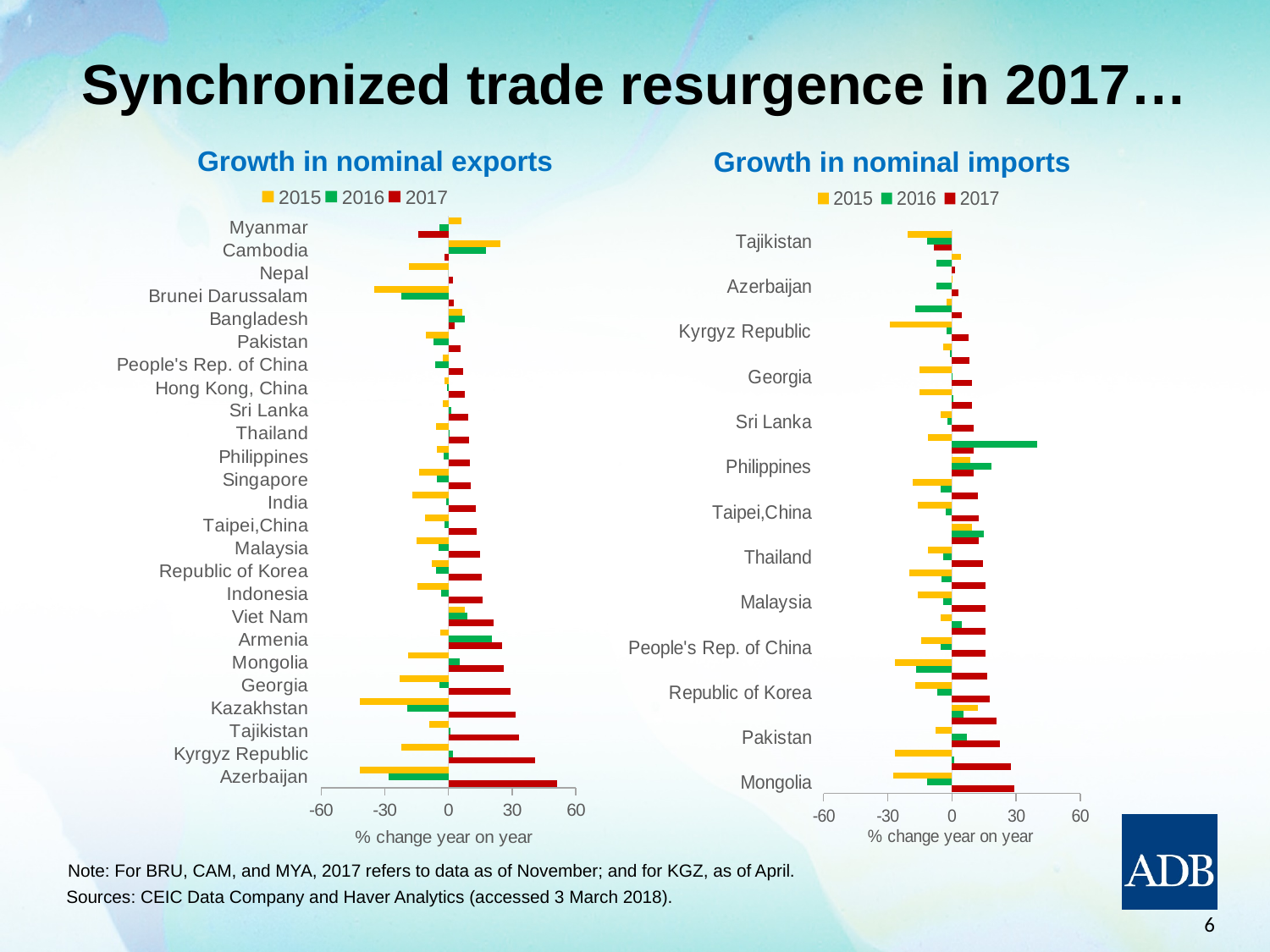
In the 'Growth in nominal exports' chart, how many economies are listed on the vertical axis? 25 In the 'Growth in nominal exports' chart, is the 2015 value for Kazakhstan greater or less than -30? less In the 'Growth in nominal imports' chart, is the 2017 value for Pakistan greater or less than 0? greater What kind of chart is the 'Growth in nominal exports' chart? Bar chart How many series does the legend of the 'Growth in nominal imports' chart list? 3 In the 'Growth in nominal exports' chart, is the 2017 value for Azerbaijan greater or less than 30? greater What is the x-axis label on the 'Growth in nominal imports' chart? % change year on year In the 'Growth in nominal exports' chart, which economy has the highest 2017 value? Azerbaijan Which colour represents 2017 in the legend of the 'Growth in nominal exports' chart? Red In the 'Growth in nominal exports' chart, which is larger: the 2015 value for Cambodia or the 2015 value for Nepal? Cambodia In the 'Growth in nominal imports' chart, which is larger: the 2017 value for Mongolia or the 2017 value for Tajikistan? Mongolia